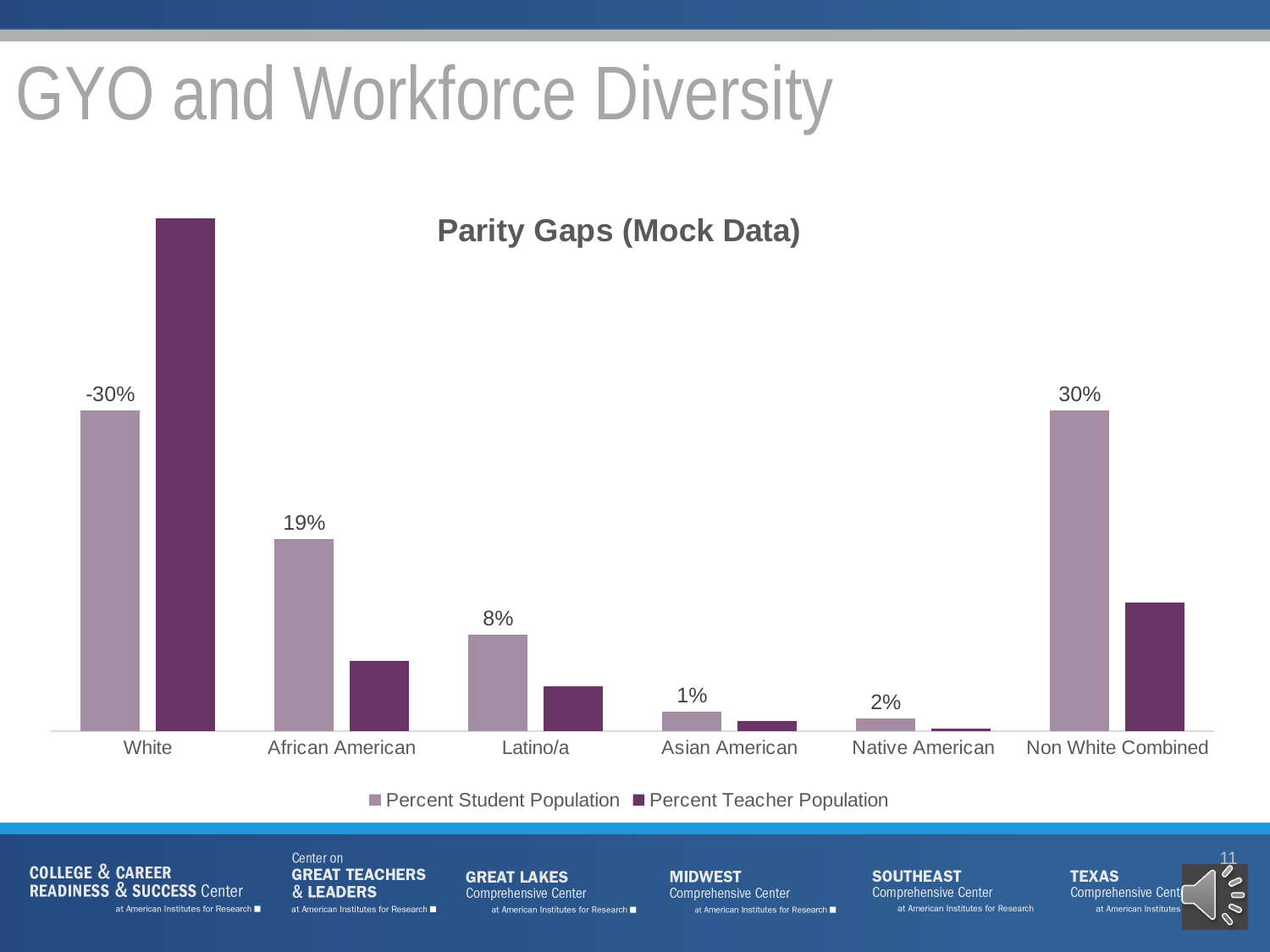
What data label is printed above the bars for Latino/a? 8% What data label is printed above the bars for White? -30% What data label is printed above the bars for African American? 19% Which category has the shortest Percent Teacher Population bar? Native American How many series does the legend list? 2 What are the two series named in the legend? Percent Student Population and Percent Teacher Population What kind of chart is shown on the slide? bar chart What data label is printed above the bars for Non White Combined? 30% For Non White Combined, which is larger: the Percent Student Population bar or the Percent Teacher Population bar? Percent Student Population How many categories are shown on the x axis? 6 What is the title of the chart? Parity Gaps (Mock Data) Which category has the tallest Percent Teacher Population bar? White